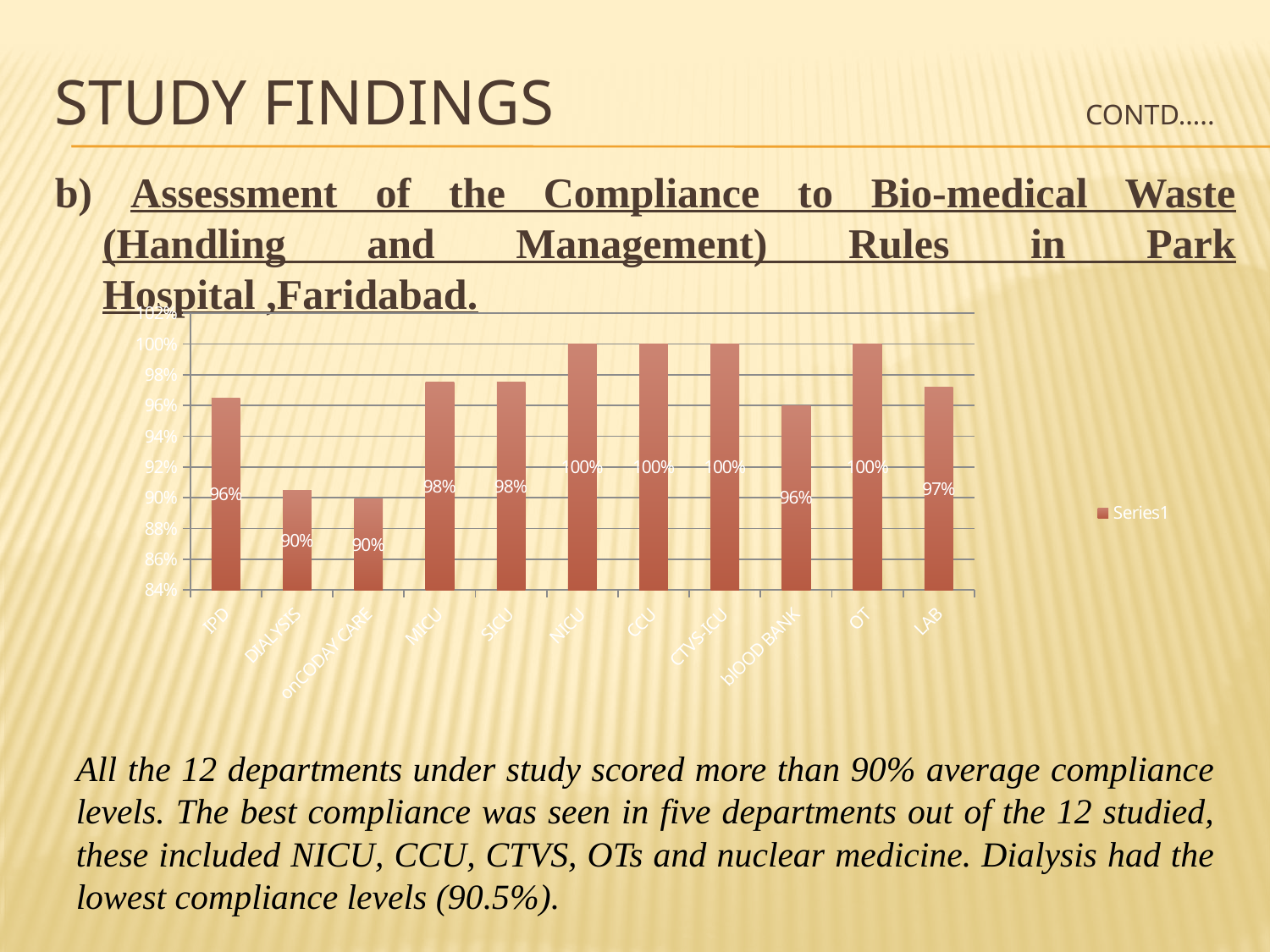
What is the value shown for IPD? 96% Is the value for SICU greater or less than 94%? greater Which is larger, the value for MICU or the value for IPD? MICU How many series does the legend list? 1 What is the value shown for MICU? 98% What is the value shown for BLOOD BANK? 96% What kind of chart is shown on the slide? bar chart Is the value for DIALYSIS greater or less than 92%? less What is the value shown for LAB? 97% How many categories are plotted on the x axis? 11 What is the value shown for NICU? 100% What is the difference between the value for CCU and the value for BLOOD BANK? 4%